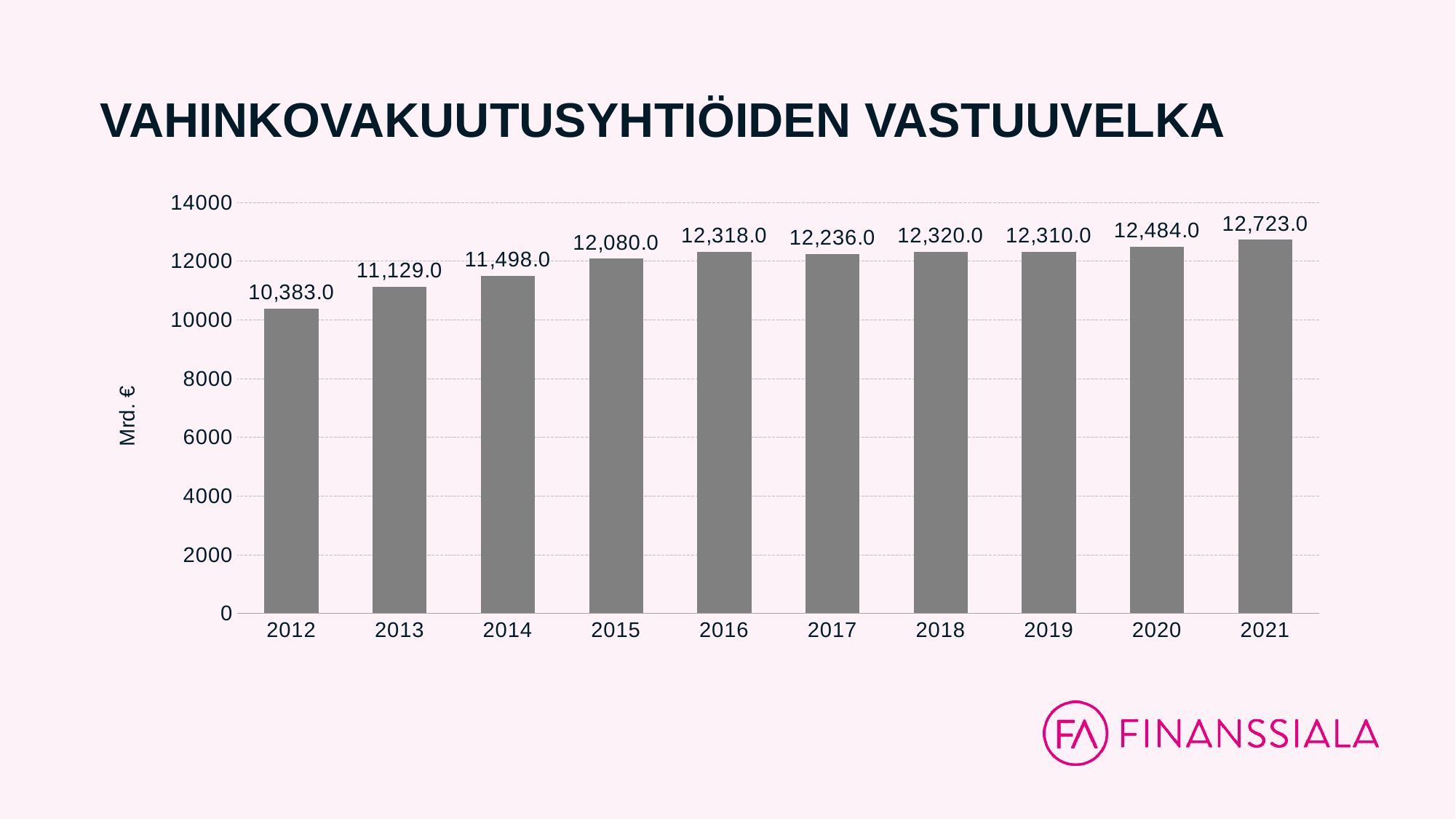
Which is larger, the value for 2016 or the value for 2017? 2016 What kind of chart is shown on the slide? bar chart What is the difference between the values for 2014 and 2013? 369.0 What is the value for 2017? 12,236.0 Which year has the lowest value? 2012 How many years are shown on the x axis? 10 What is the value for 2012? 10,383.0 Which year has the highest value? 2021 Is the value for 2015 greater or less than 12000? greater What is the difference between the values for 2021 and 2012? 2,340.0 What unit is shown on the y axis label? Mrd. € What is the value for 2020? 12,484.0